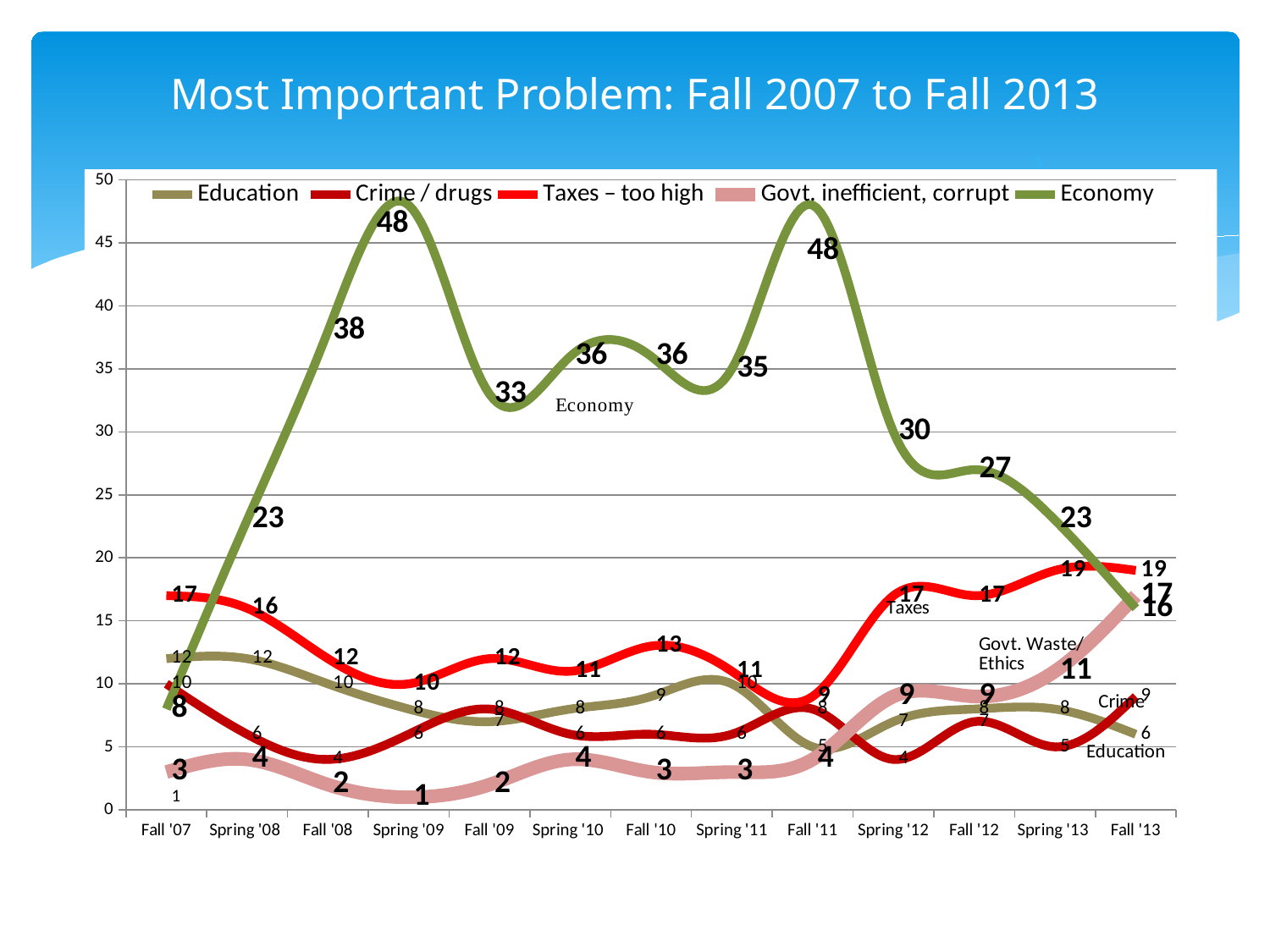
How many time points are shown on the x axis? 13 What is the value for Taxes – too high in Fall '13? 19 What is the difference between the Economy value in Fall '11 and in Spring '12? 18 What is the Economy value for Spring '09? 48 In Fall '08, which is larger: the Economy value or the Taxes – too high value? Economy What is the Economy value for Fall '08? 38 What is the highest value reached by the Economy line? 48 What kind of chart is shown on the slide? Line chart How many series does the legend list? 5 What is the value for Govt. inefficient, corrupt in Spring '13? 11 What is the difference between the Economy value in Spring '09 and in Fall '13? 32 What is the Economy value for Fall '13? 16